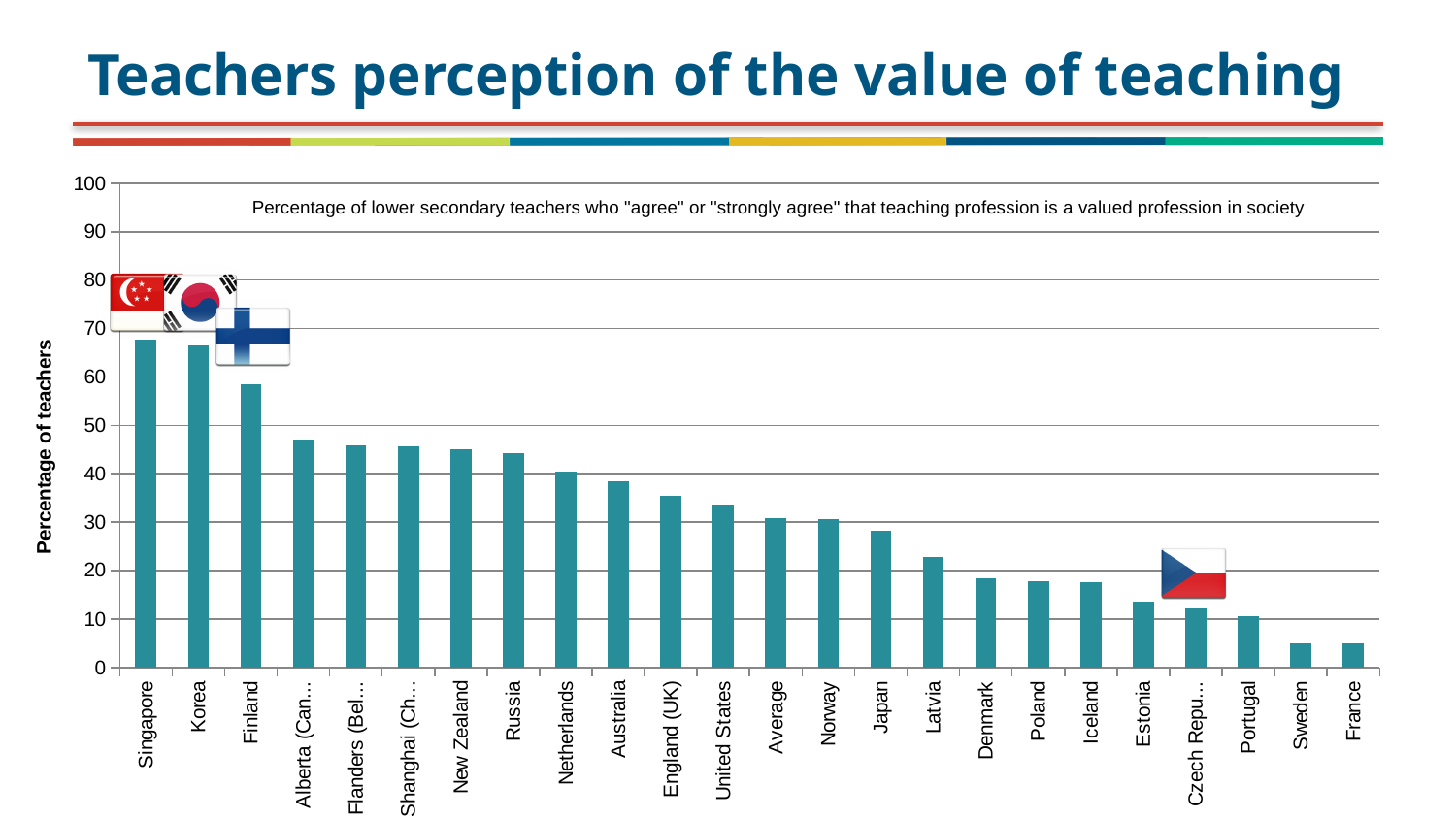
Is the value for United States greater or less than 30? greater Is the value for Japan greater or less than 30? less What kind of chart is shown on the slide? Bar chart Is the value for Denmark greater or less than 20? less Which has the larger value, Latvia or Japan? Japan Do the bar values rise or fall moving from left to right along the x axis? Fall What is the label on the vertical axis of the chart? Percentage of teachers Which has the larger value, Finland or New Zealand? Finland How many bars (categories) are plotted in the chart? 24